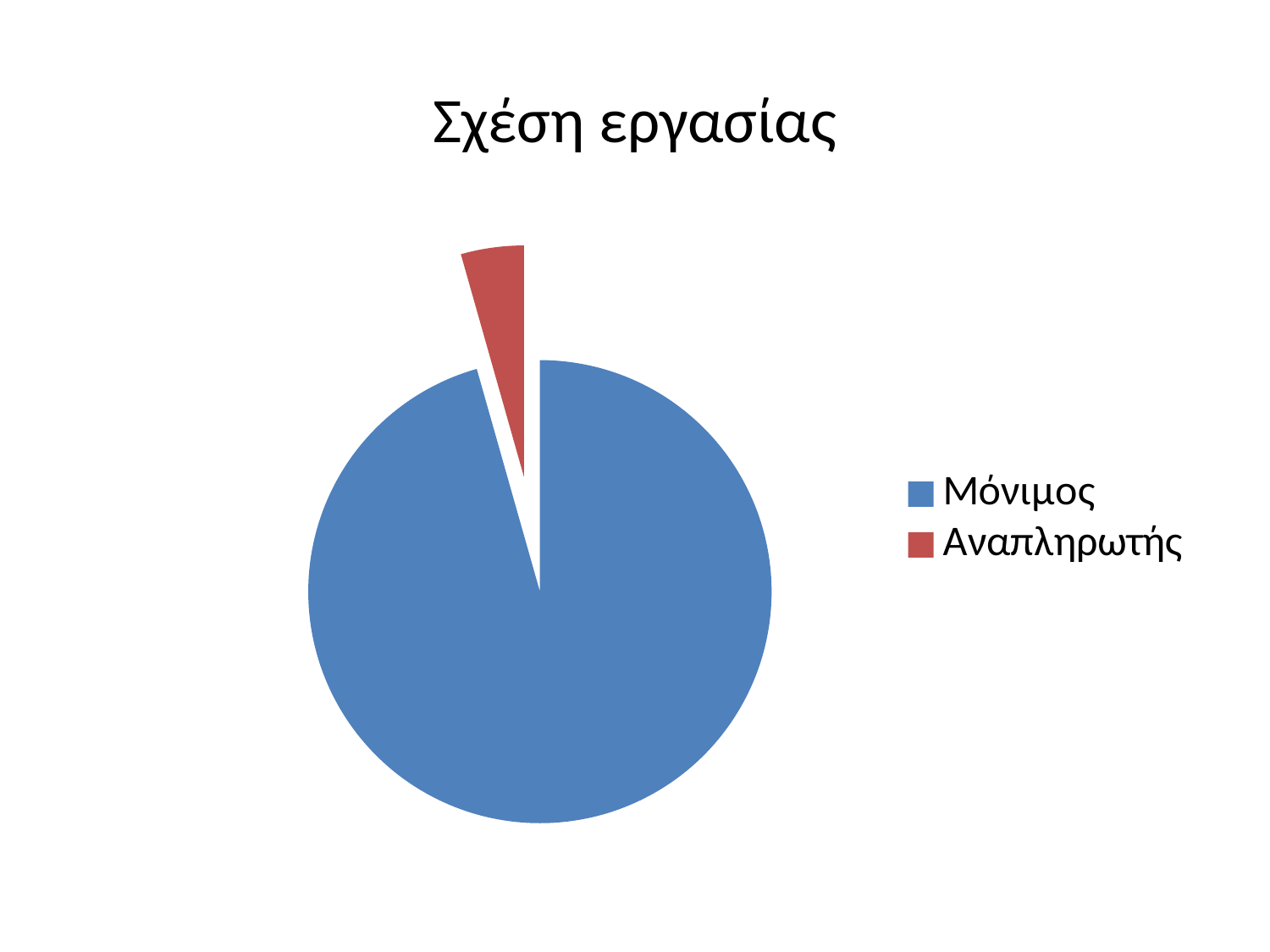
Which is larger, the slice for Μόνιμος or the slice for Αναπληρωτής? Μόνιμος What kind of chart is shown on the slide? pie chart What is the title of the chart? Σχέση εργασίας What colour is the slice for Αναπληρωτής? red How many categories does the pie chart have? 2 Which category has the smallest slice of the pie? Αναπληρωτής Which category has the largest slice of the pie? Μόνιμος How many entries does the legend list? 2